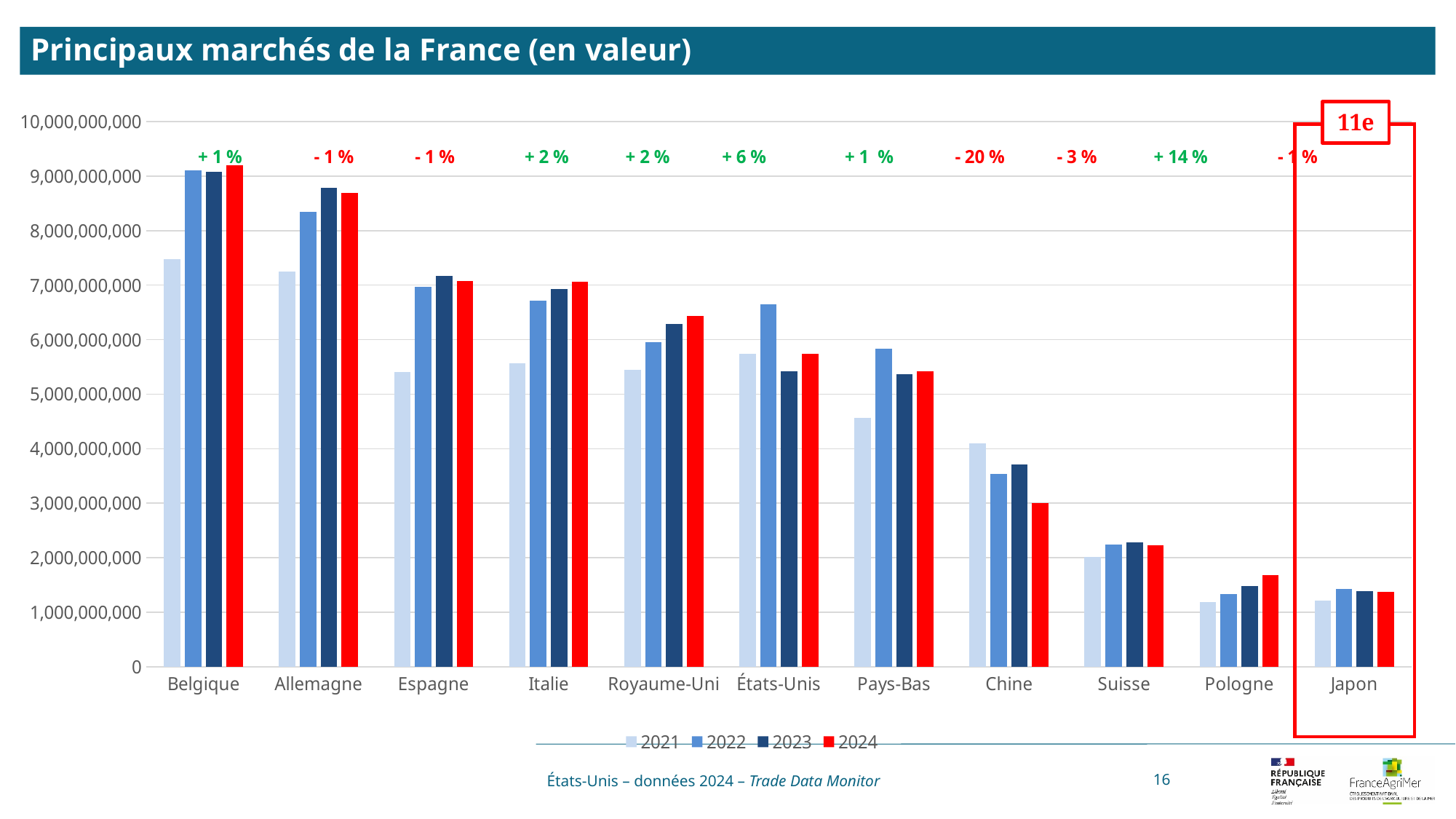
What percentage change is printed above the bars for Pologne? + 14 % What rank label is shown in the red box above Japon? 11e How many countries are shown on the x axis of the chart? 11 Do the 2024 values generally rise or fall moving from Belgique to Japon along the x axis? fall Is the 2021 value for Pologne greater or less than 2,000,000,000? less How many series does the legend list? 4 Which country has the lowest value for 2024? Japon Which country has the highest value for 2024? Belgique Is the 2022 value for États-Unis greater or less than 6,000,000,000? greater Which is larger, the 2024 value for Royaume-Uni or the 2024 value for États-Unis? Royaume-Uni What kind of chart is shown on the slide? bar chart What percentage change is printed above the bars for Chine? - 20 %